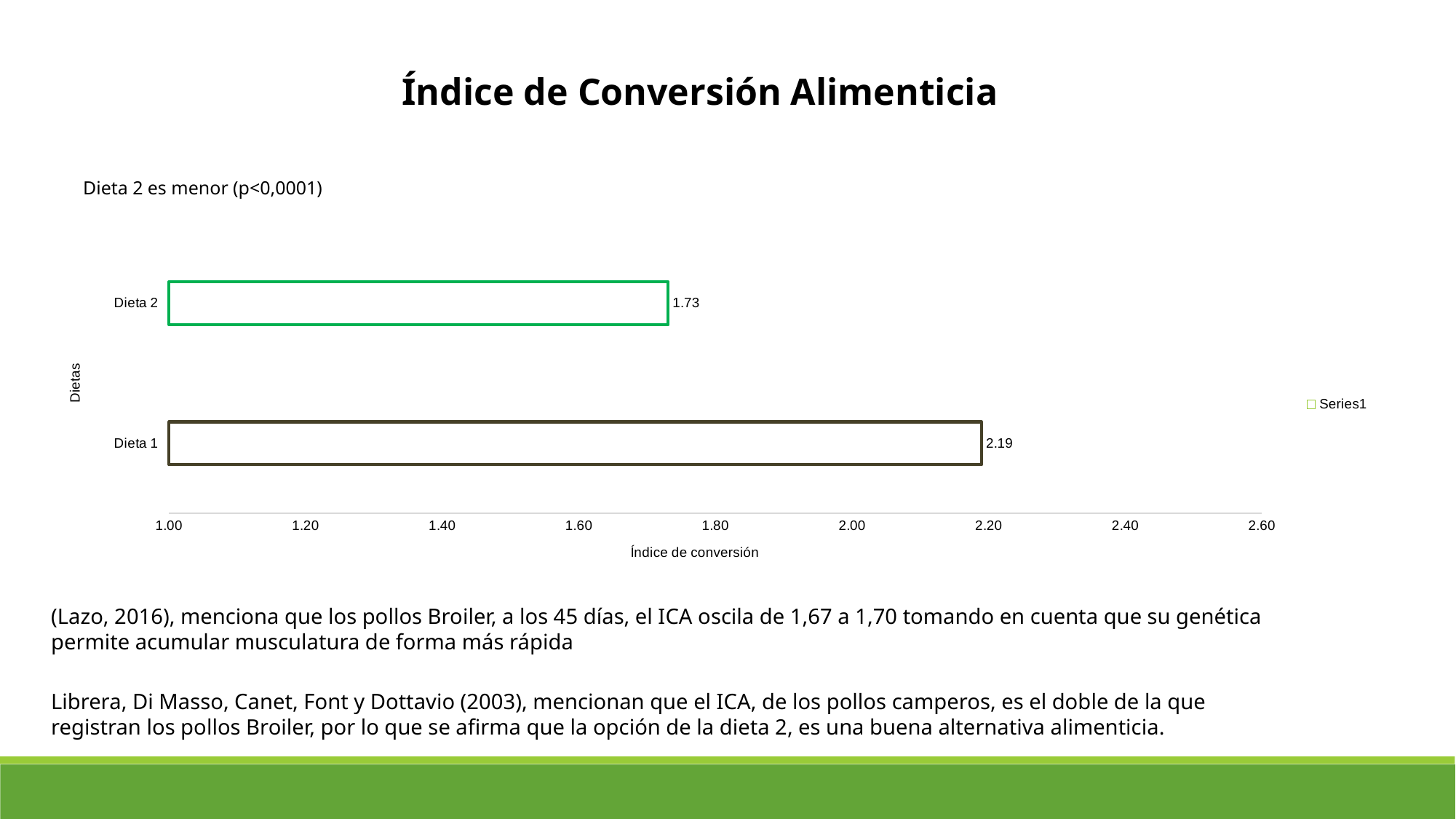
How many series does the legend list? 1 What kind of chart is shown on the slide? Bar chart What is the difference between the values for Dieta 1 and Dieta 2? 0.46 What is the value for Dieta 1? 2.19 Is the value for Dieta 1 greater or less than 2.00? greater Is the value for Dieta 2 greater or less than 1.80? less What is the value for Dieta 2? 1.73 What is the label of the horizontal axis? Índice de conversión Which is larger, the value for Dieta 1 or the value for Dieta 2? Dieta 1 How many diets are shown in the chart? 2 Which diet has the lowest índice de conversión? Dieta 2 Which diet has the highest índice de conversión? Dieta 1